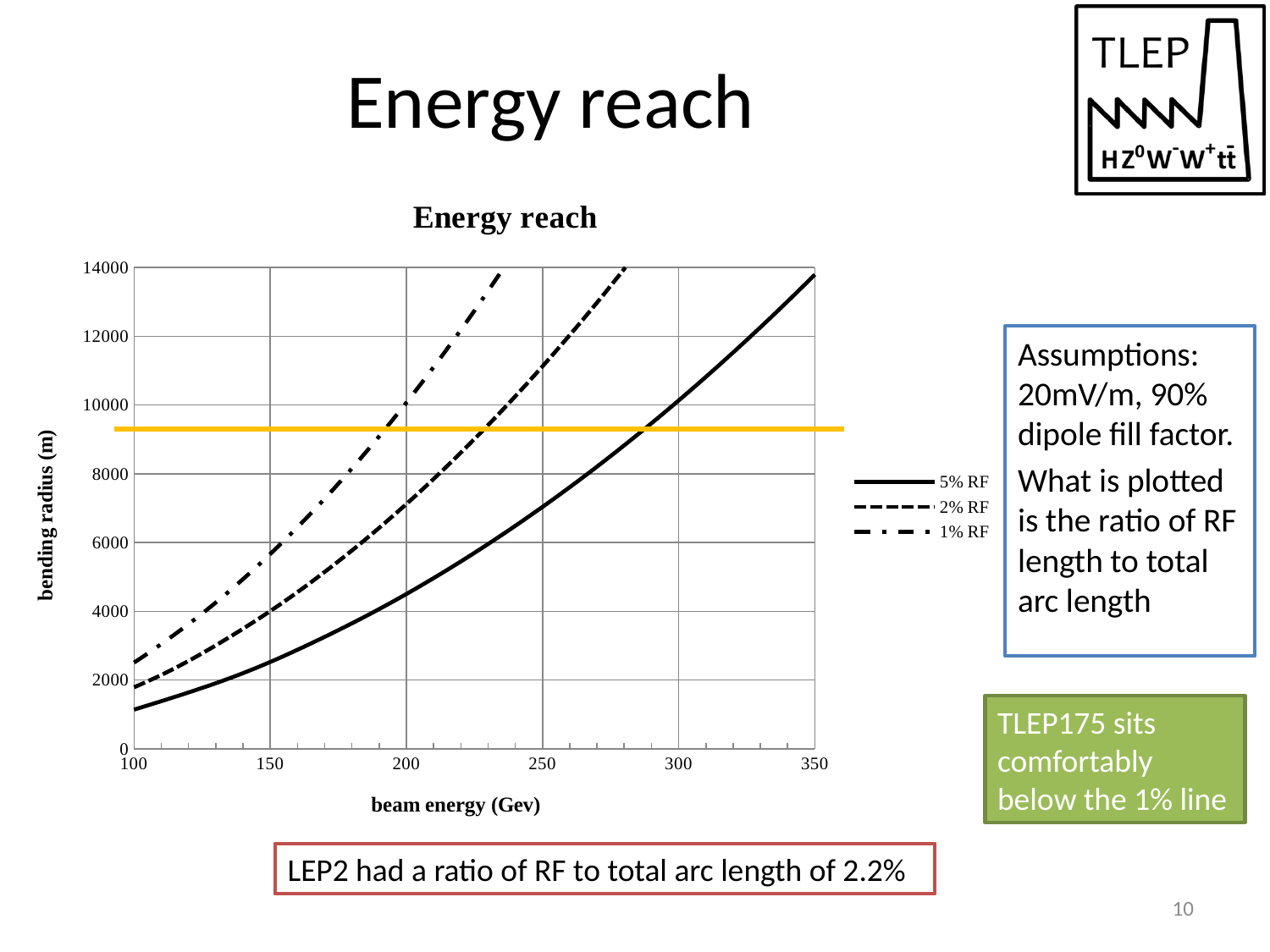
What are the three series listed in the chart legend? 5% RF, 2% RF, 1% RF Is the bending radius for the 5% RF series at 350 GeV greater or less than 12000? greater Is the bending radius for the 5% RF series at 200 GeV greater or less than 6000? less Is the bending radius for the 5% RF series at 100 GeV greater or less than 2000? less What is the label of the chart's x axis? beam energy (Gev) At a beam energy of 150 GeV, which of the three series has the lowest bending radius? 5% RF What kind of chart is shown on the slide? line chart How many series does the chart legend list? 3 Does the bending radius for the 5% RF series rise or fall as beam energy increases? rise At a beam energy of 250 GeV, which series has the larger bending radius, 2% RF or 5% RF? 2% RF